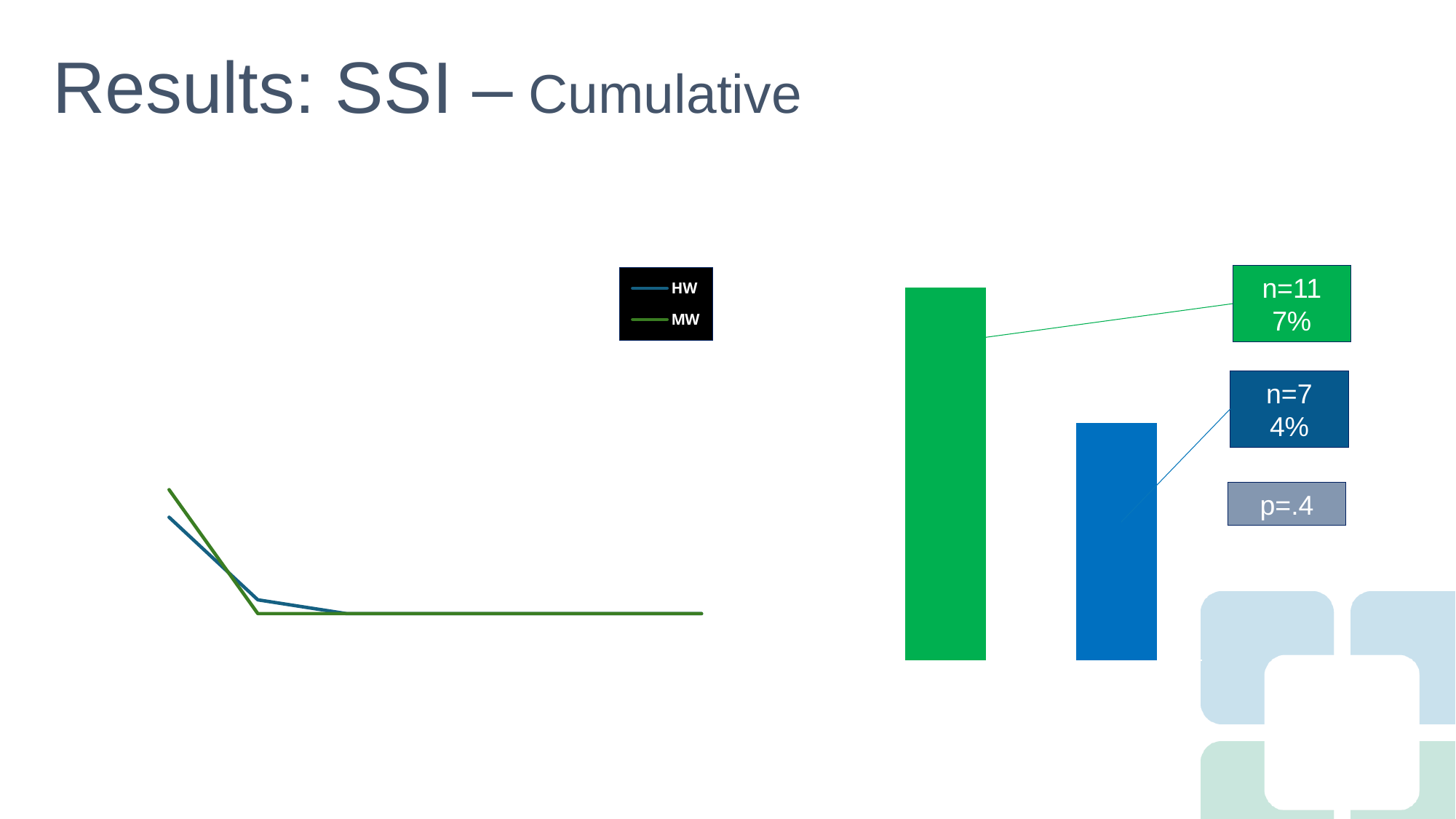
In the right chart, which bar is taller, the green bar or the blue bar? the green bar In the right chart, what percentage is labelled on the green bar? 7% In the right chart, what count (n) is labelled on the green bar? n=11 In the right chart, what is the difference in n between the green bar (n=11) and the blue bar (n=7)? 4 How many series does the legend of the left chart list? 2 What are the two series named in the legend of the left chart? HW and MW In the right chart, what p-value is shown? p=.4 What kind of chart is the chart on the left of the slide? line chart In the left chart, do the lines rise or fall from the leftmost point to the right? fall What kind of chart is the chart on the right of the slide? bar chart How many bars are plotted in the right chart? 2 In the right chart, what percentage is labelled on the blue bar? 4%